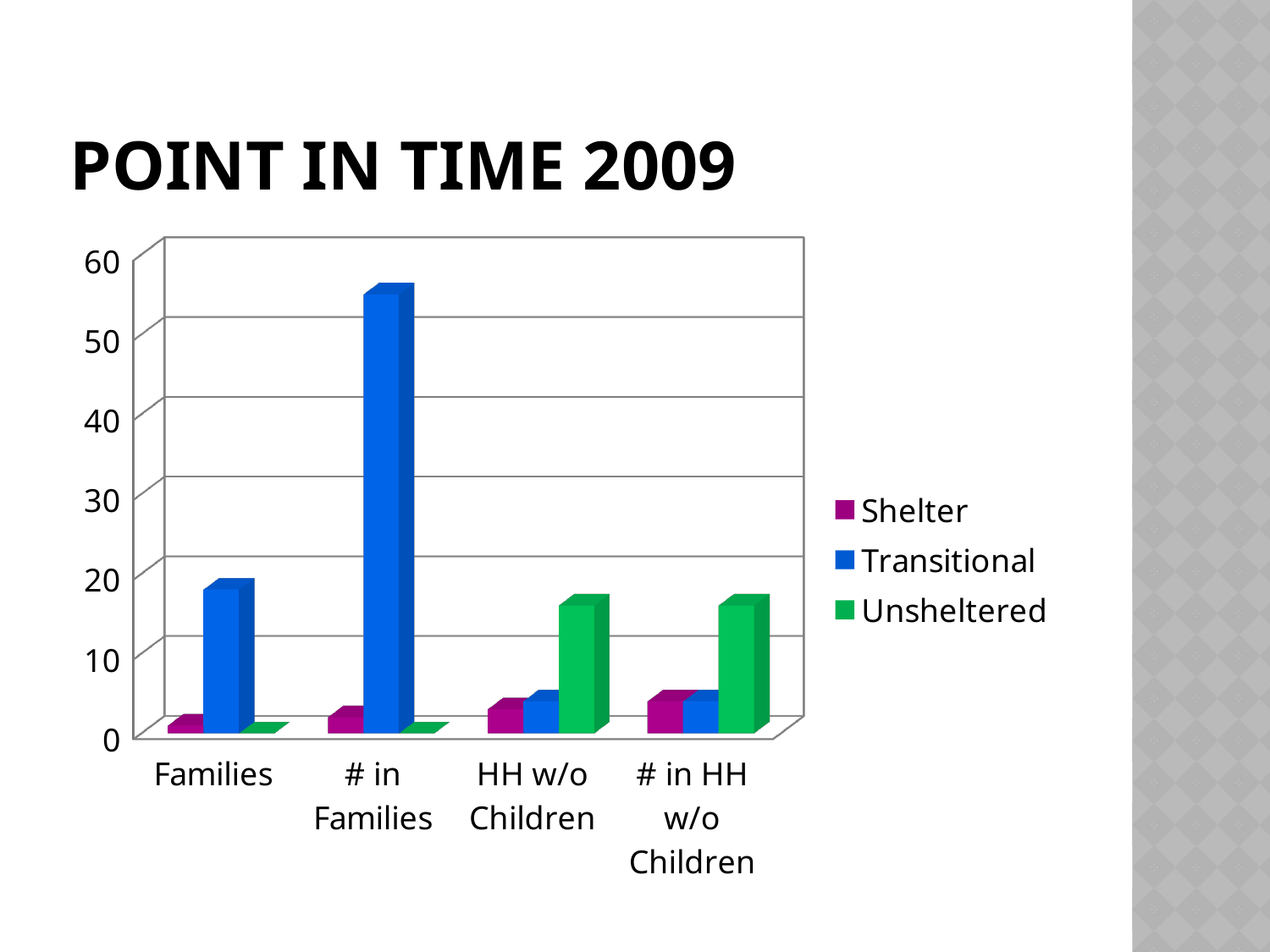
Is the Transitional value for # in Families greater or less than 50? greater What kind of chart is shown on the slide? bar chart Is the Transitional value for Families greater or less than 20? less What is the title of the slide? POINT IN TIME 2009 How many categories are shown on the x axis? 4 For Families, which is larger: the Transitional value or the Unsheltered value? Transitional Is the Shelter value for # in HH w/o Children greater or less than 10? less How many series does the legend list? 3 Which series is shown in green in the legend? Unsheltered Which category has the highest Transitional value? # in Families For HH w/o Children, which is larger: the Unsheltered value or the Shelter value? Unsheltered